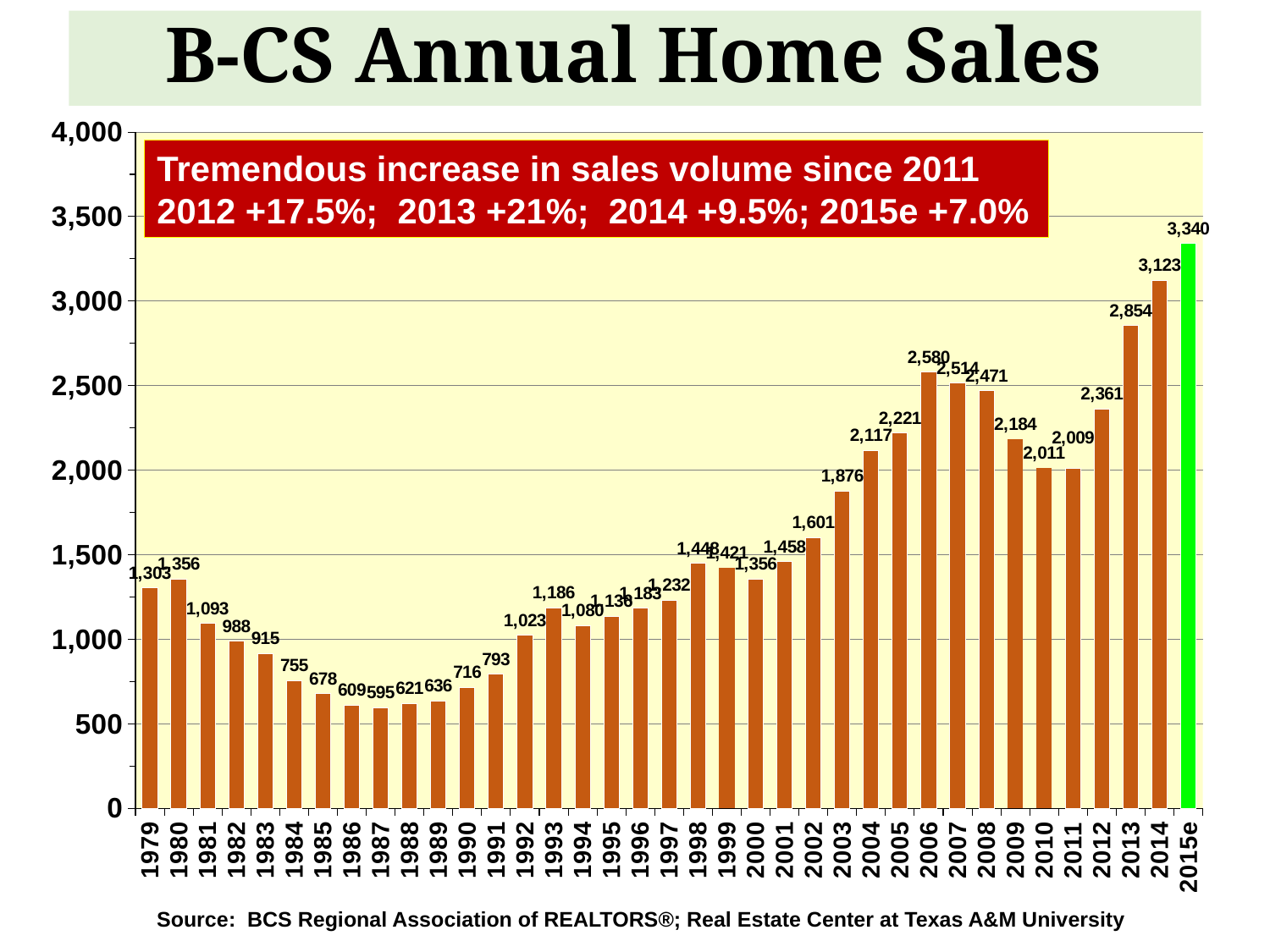
What kind of chart is shown on the slide? bar chart What is the value for 2014? 3,123 Is the value for 1984 greater or less than 1,000? less Which is larger, the value for 2003 or the value for 2009? 2009 Which year has the lowest value? 1987 What is the value for 1987? 595 How many bars are shown in the chart? 37 What is the estimated value for 2015e? 3,340 Which year has the highest value? 2015e What is the difference between the values for 2014 and 2013? 269 Do the values rise or fall from 1979 to 1987? fall What is the value for 2006? 2,580